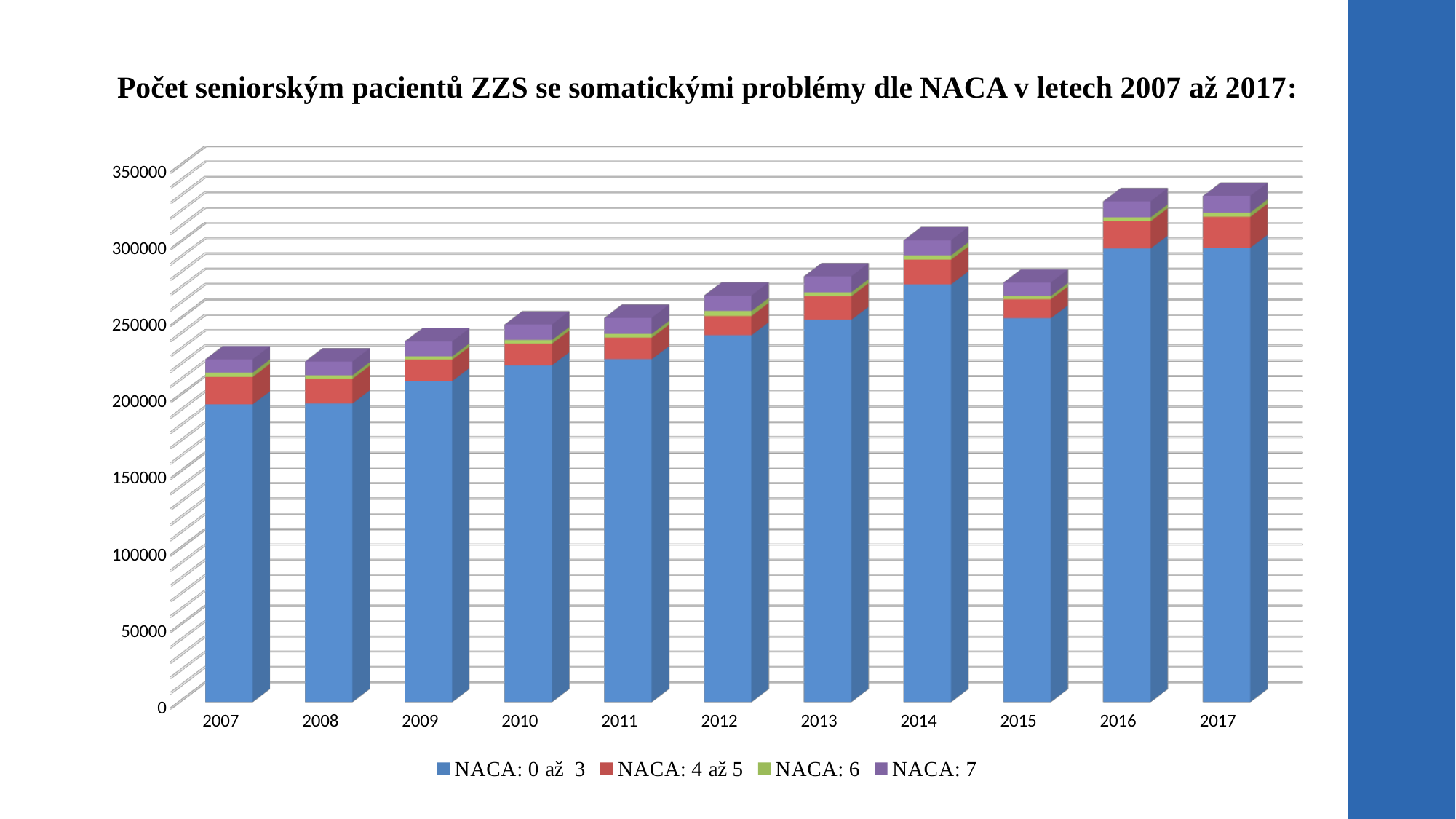
Is the NACA: 0 až 3 value for 2016 greater or less than 250000? greater Which series is shown in purple? NACA: 7 How many series does the legend list? 4 Is the total bar for 2007 greater or less than 250000? less Which series forms the largest (bottom) segment of each bar? NACA: 0 až 3 Is the total bar for 2016 greater or less than 300000? greater How many years (categories) are shown on the x axis? 11 Which year has the taller total bar, 2009 or 2012? 2012 Do the total bar heights generally rise or fall from 2007 to 2017? rise What kind of chart is shown on the slide? Stacked bar chart Which year has the taller total bar, 2014 or 2015? 2014